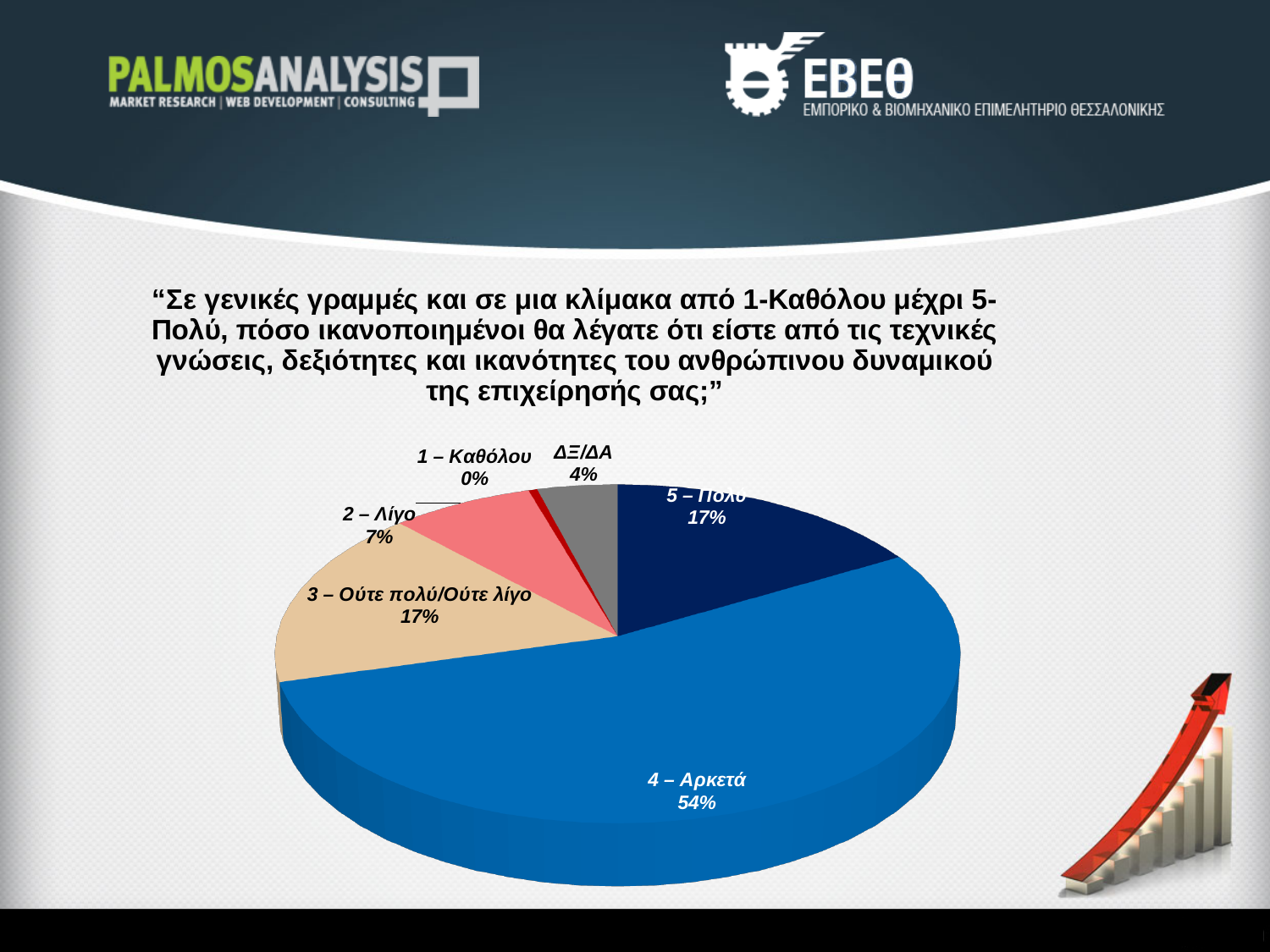
Which category has the largest share of the pie? 4 – Αρκετά What percentage of respondents answered "2 – Λίγο"? 7% What kind of chart is shown on the slide? pie chart Which is larger, the share for "2 – Λίγο" or the share for "ΔΞ/ΔΑ"? 2 – Λίγο What percentage of respondents answered "5 – Πολύ"? 17% What percentage of respondents answered "4 – Αρκετά"? 54% What percentage is shown for "ΔΞ/ΔΑ"? 4% What percentage is shown for "1 – Καθόλου"? 0% What is the difference in percentage points between "4 – Αρκετά" and "3 – Ούτε πολύ/Ούτε λίγο"? 37 How many categories are shown in the pie chart? 6 Which category has the smallest share of the pie? 1 – Καθόλου What colour is the slice for "4 – Αρκετά"? blue